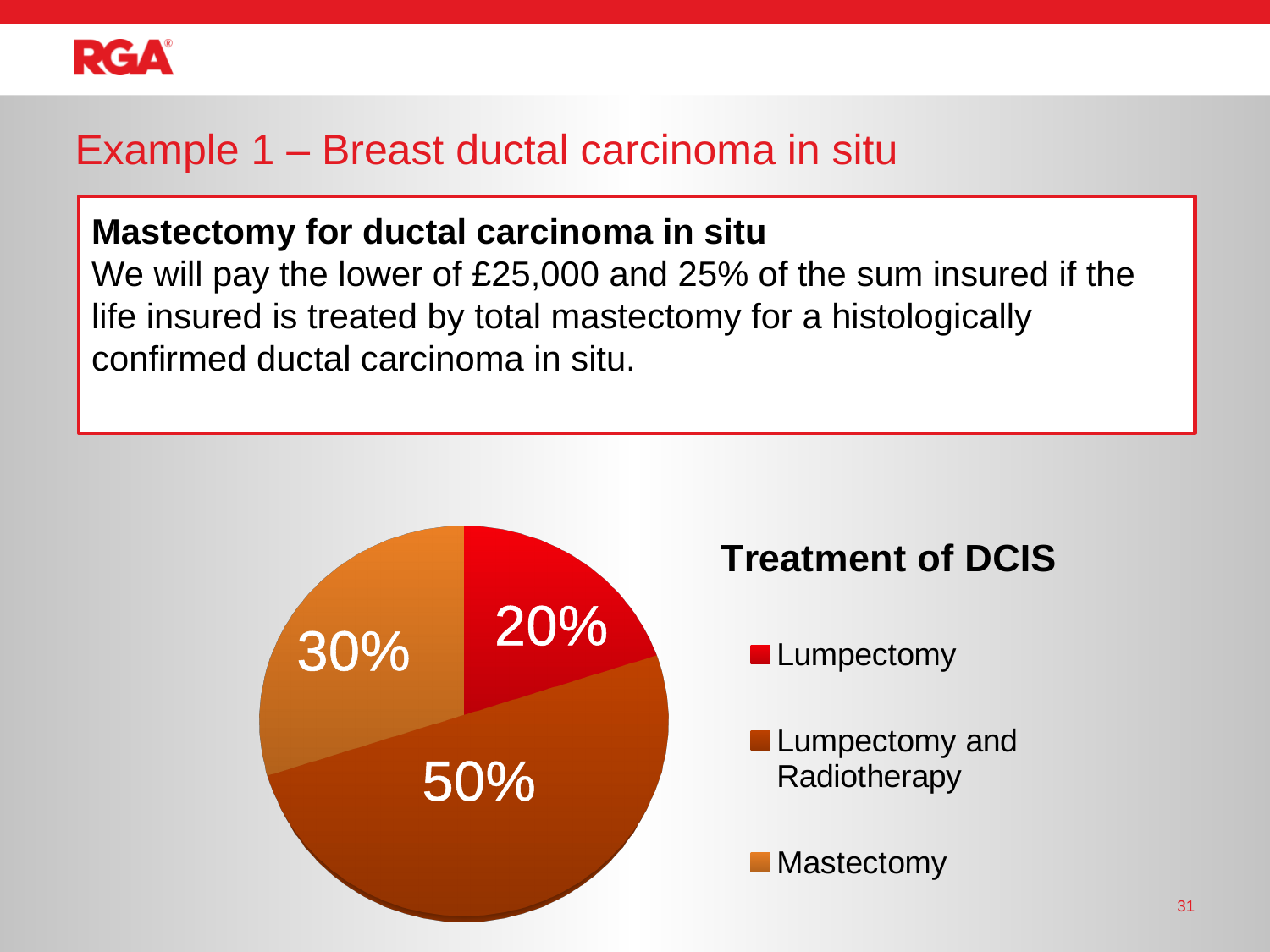
What is the difference between the shares for Lumpectomy and Radiotherapy and Mastectomy? 20% Which is larger, the share for Mastectomy or the share for Lumpectomy? Mastectomy What is the title of the chart? Treatment of DCIS Which treatment has the smallest share of the pie? Lumpectomy What kind of chart is shown on the slide? Pie chart Which treatment has the largest share of the pie? Lumpectomy and Radiotherapy What share of the pie is Lumpectomy? 20% What share of the pie is Lumpectomy and Radiotherapy? 50% How many slices does the pie chart have? 3 How many entries does the legend list? 3 What colour is the Lumpectomy slice? Red What share of the pie is Mastectomy? 30%